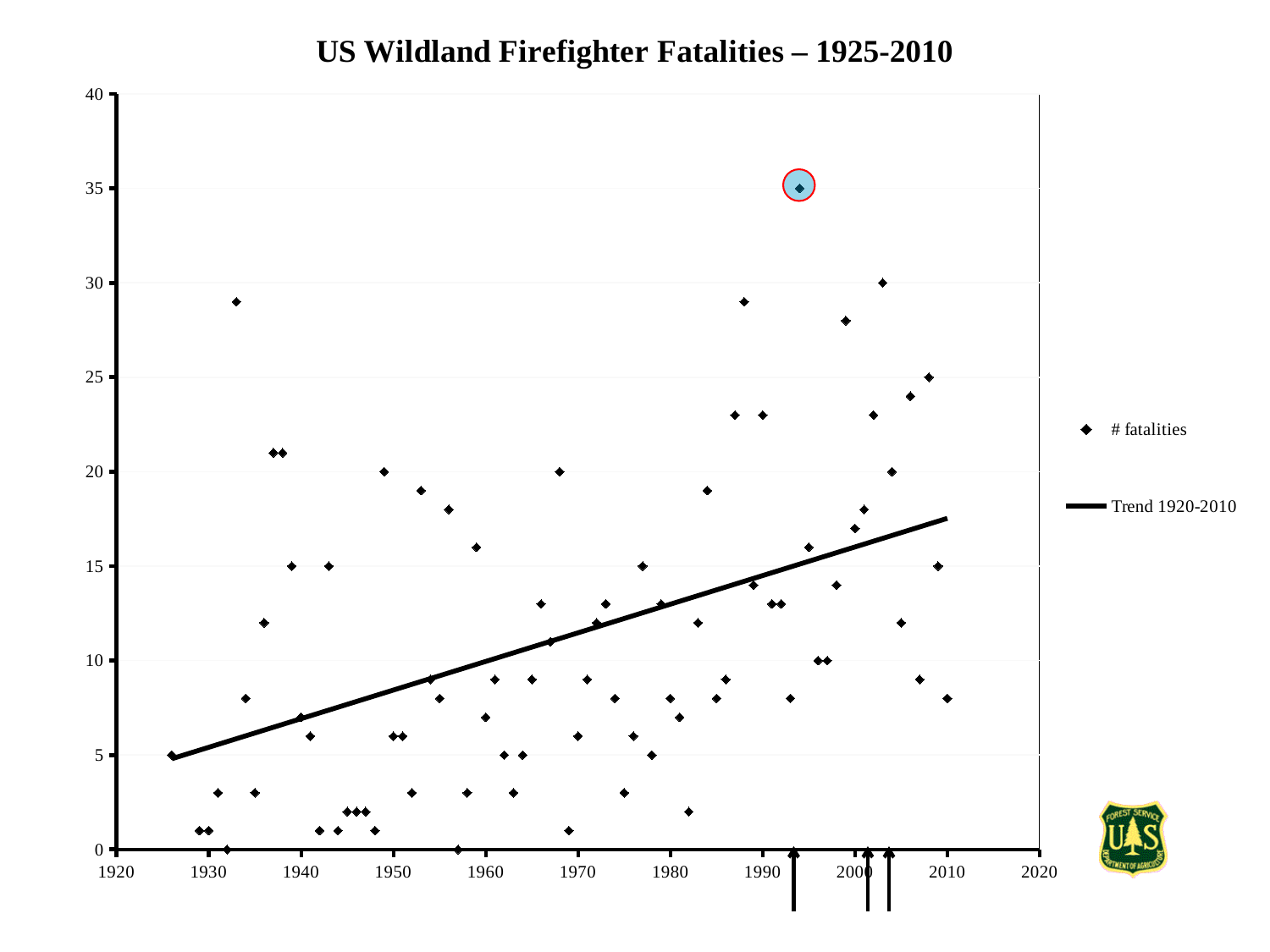
What is the value of the circled (highlighted) data point on the chart? 35 Is the value of the data point at 1950 greater or less than 10? less What kind of chart is shown on the slide? scatter chart Does the trend line on the chart rise or fall from 1920 to 2010? rise What is the title of the chart? US Wildland Firefighter Fatalities – 1925-2010 What is the highest number of fatalities plotted on the chart? 35 Is the value of the data point at 1990 greater or less than 10? greater Is the value of the trend line at 1930 greater or less than 10? less What are the two legend entries on the chart? # fatalities and Trend 1920-2010 How many entries does the chart's legend list? 2